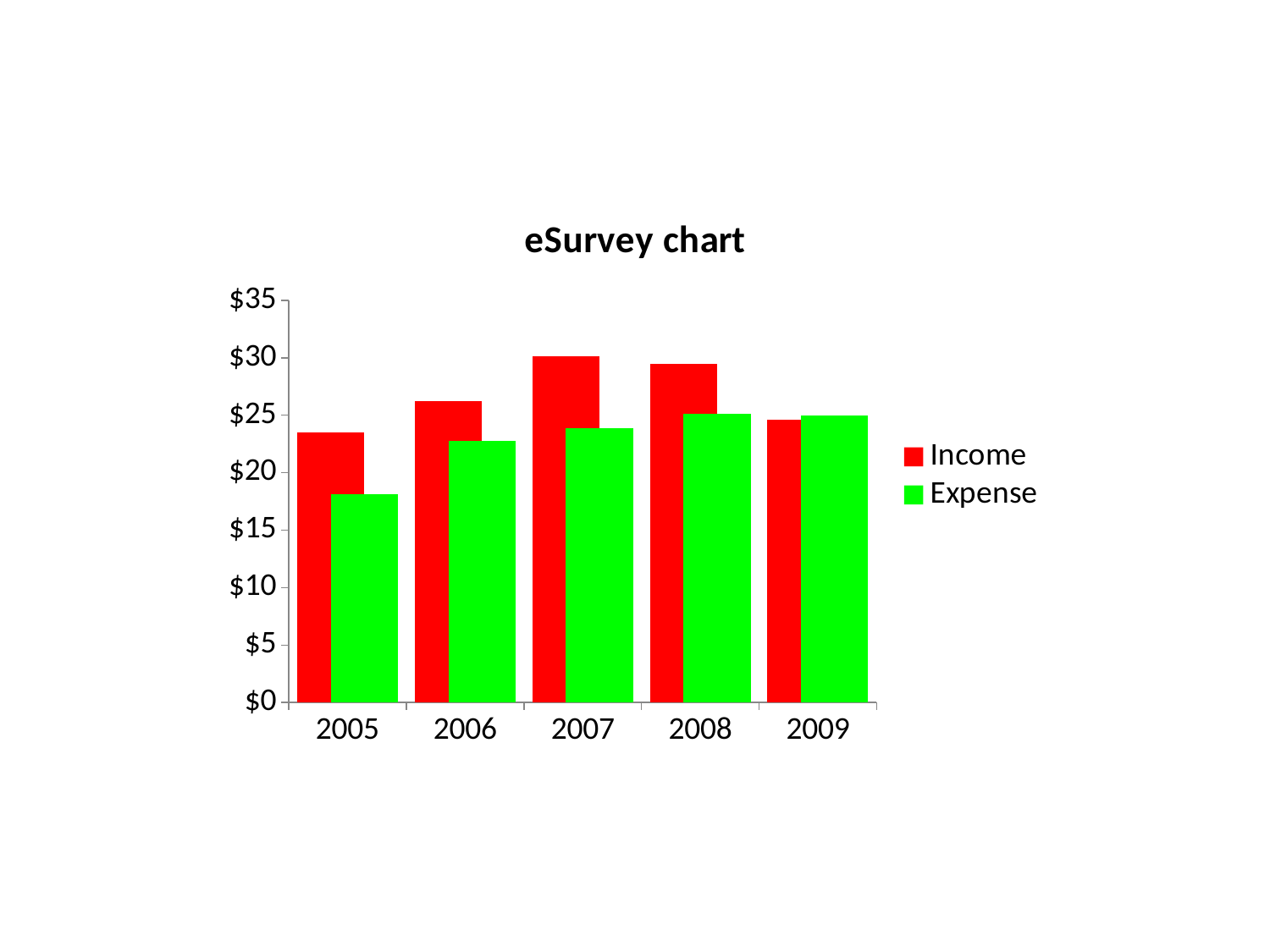
What is the title of the chart? eSurvey chart What kind of chart is shown on the slide? bar chart Is the Income value for 2007 greater or less than $25? greater How many years are shown on the x axis? 5 In which year is Expense lowest? 2005 Which colour represents Expense in the legend? green Does Expense rise or fall from 2005 to 2008? rise Is the Expense value for 2005 greater or less than $20? less How many series does the legend list? 2 Is the Expense value for 2006 greater or less than $20? greater In 2005, which is larger, Income or Expense? Income In which year is Income highest? 2007